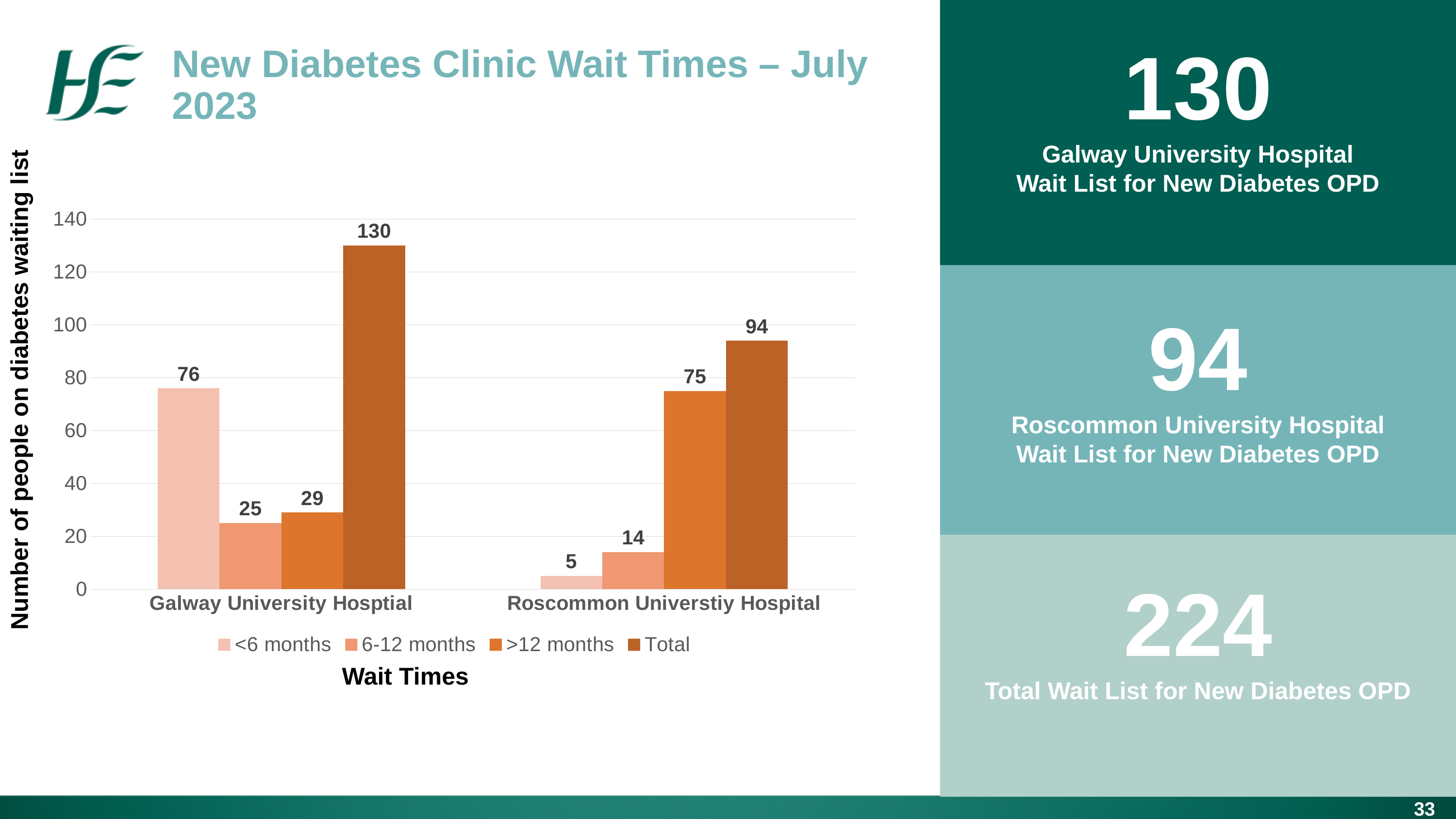
What is the value for <6 months at Galway University Hospital? 76 What is the value for 6-12 months at Galway University Hospital? 25 What kind of chart is shown on the slide? Bar chart How many series does the chart legend list? 4 Which hospital has the higher Total value? Galway University Hospital What is the Total value for Roscommon Universtiy Hospital? 94 Which is larger: the >12 months value at Galway University Hospital or the >12 months value at Roscommon Universtiy Hospital? Roscommon Universtiy Hospital Is the value for <6 months at Galway University Hospital greater or less than 60? greater What is the value for >12 months at Roscommon Universtiy Hospital? 75 How many hospitals are shown on the x axis of the chart? 2 What is the difference between the Total values for Galway University Hospital and Roscommon Universtiy Hospital? 36 Which series has the lowest value at Roscommon Universtiy Hospital? <6 months